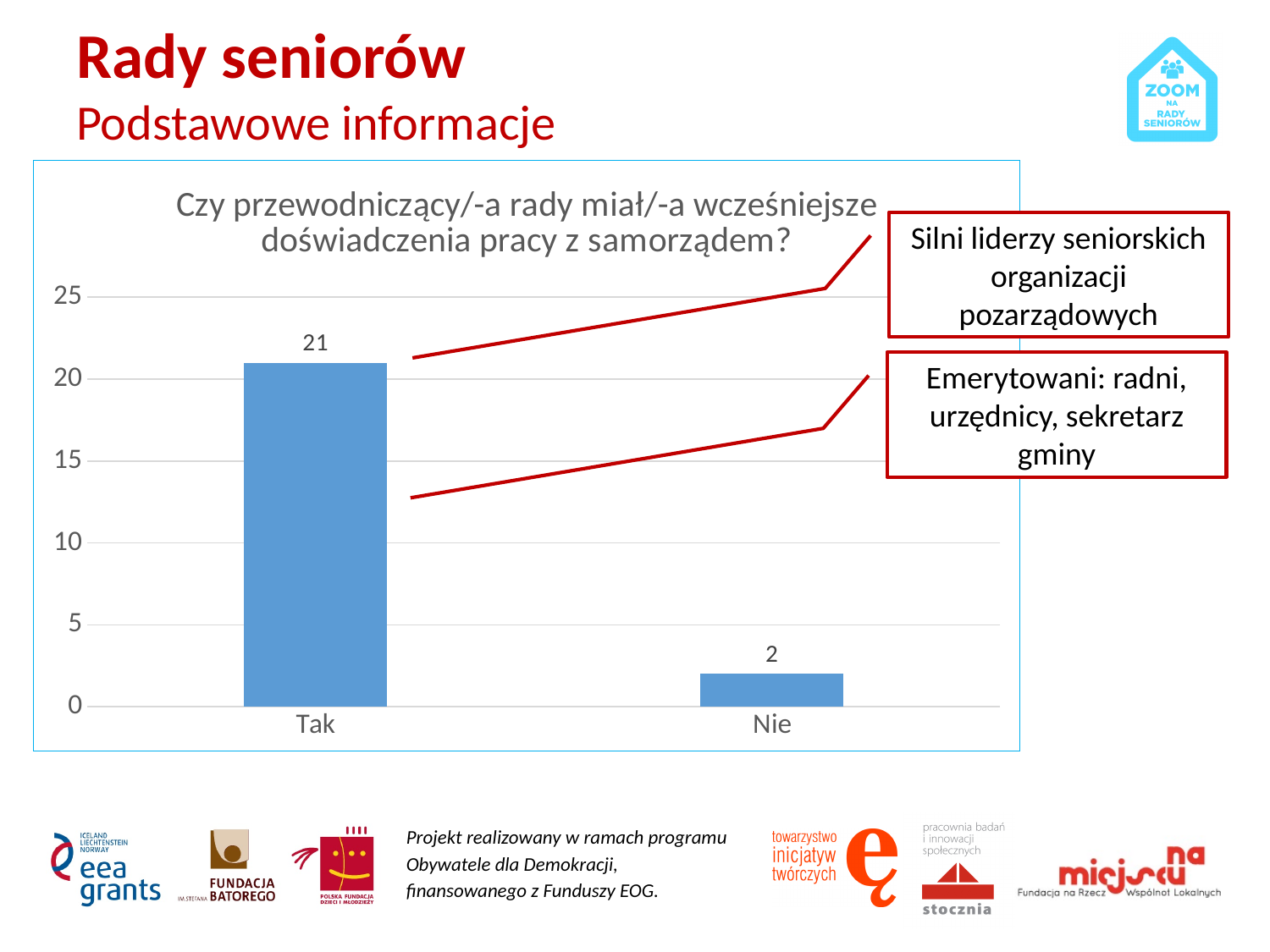
Is the value for "Tak" greater or less than 20? greater What is the title of the chart? Czy przewodniczący/-a rady miał/-a wcześniejsze doświadczenia pracy z samorządem? Which category has the lowest value? Nie What is the highest value shown on the y axis? 25 Which category has the highest value? Tak What is the value for "Nie"? 2 What kind of chart is shown on the slide? bar chart Which is larger, the value for "Tak" or the value for "Nie"? Tak What is the difference between the values for "Tak" and "Nie"? 19 How many categories are shown on the x axis? 2 What is the value for "Tak"? 21 Is the value for "Nie" greater or less than 5? less